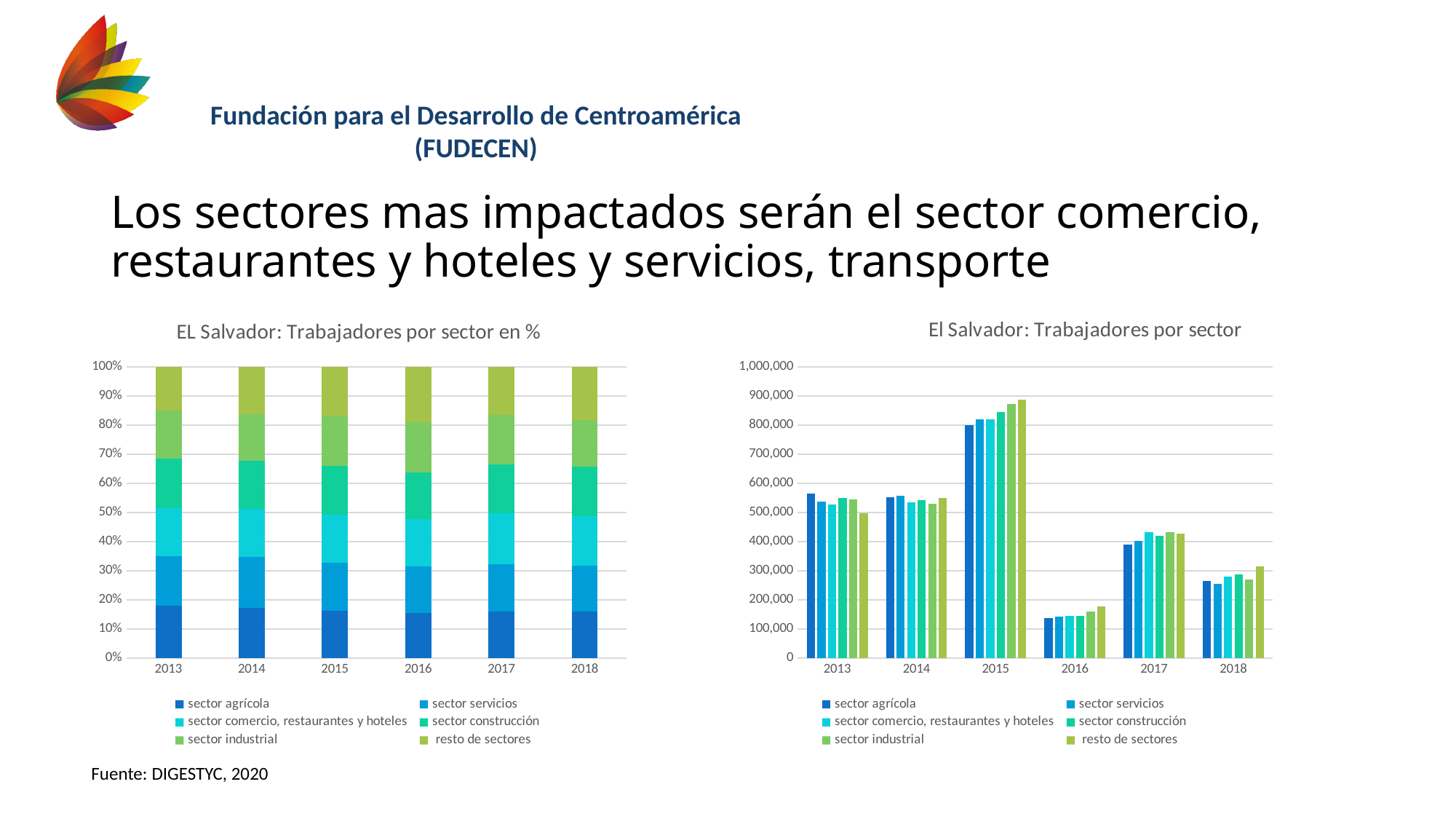
In the left chart 'EL Salvador: Trabajadores por sector en %', is the share of 'sector agrícola' in 2016 greater or less than 20%? less In the right chart 'El Salvador: Trabajadores por sector', is the value for 'sector agrícola' in 2016 greater or less than 200,000? less What type of chart is the right chart titled 'El Salvador: Trabajadores por sector'? Bar chart In the right chart 'El Salvador: Trabajadores por sector', is the value for 'sector agrícola' in 2013 greater or less than 500,000? greater How many series does the legend of the left chart 'EL Salvador: Trabajadores por sector en %' list? 6 In the right chart 'El Salvador: Trabajadores por sector', which year has the highest values across all sectors? 2015 In the left chart 'EL Salvador: Trabajadores por sector en %', what is the total height of each stacked bar? 100% In the right chart 'El Salvador: Trabajadores por sector', which year has the lowest values across all sectors? 2016 In the right chart 'El Salvador: Trabajadores por sector', how many years are shown on the x axis? 6 What type of chart is the left chart titled 'EL Salvador: Trabajadores por sector en %'? Stacked bar chart